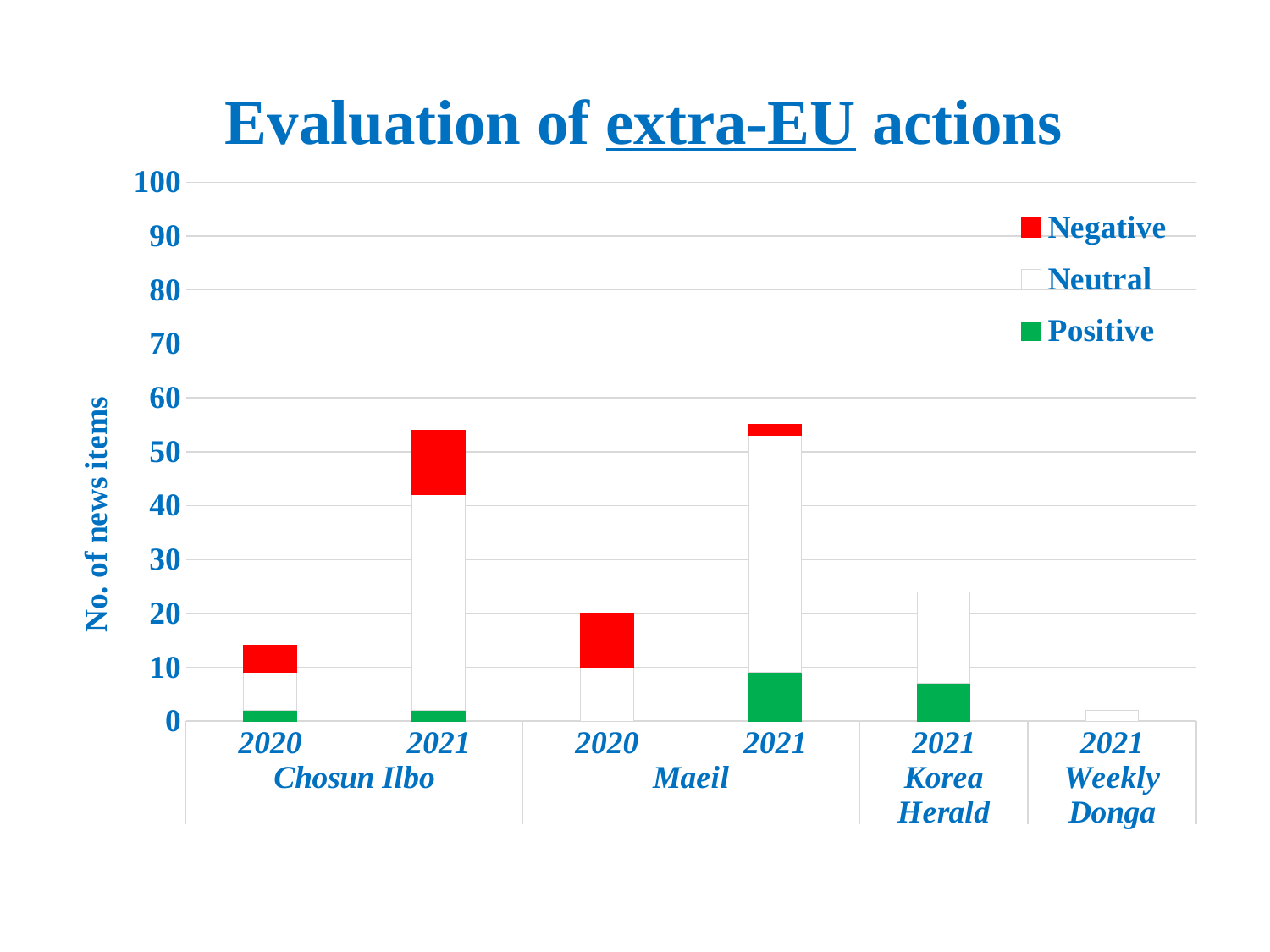
Is the total for Korea Herald 2021 greater or less than 20? greater How many series does the legend list? 3 Is the total for Weekly Donga 2021 greater or less than 10? less Which series is shown in red in the legend? Negative What is the title of the chart? Evaluation of extra-EU actions Which has a larger total: Korea Herald 2021 or Chosun Ilbo 2020? Korea Herald 2021 Did the total number of news items for Chosun Ilbo rise or fall from 2020 to 2021? Rise Which bar has the lowest total number of news items? 2021 Weekly Donga Is the total for Chosun Ilbo 2021 greater or less than 50? greater What kind of chart is shown on the slide? Stacked bar chart How many bars are plotted in the chart? 6